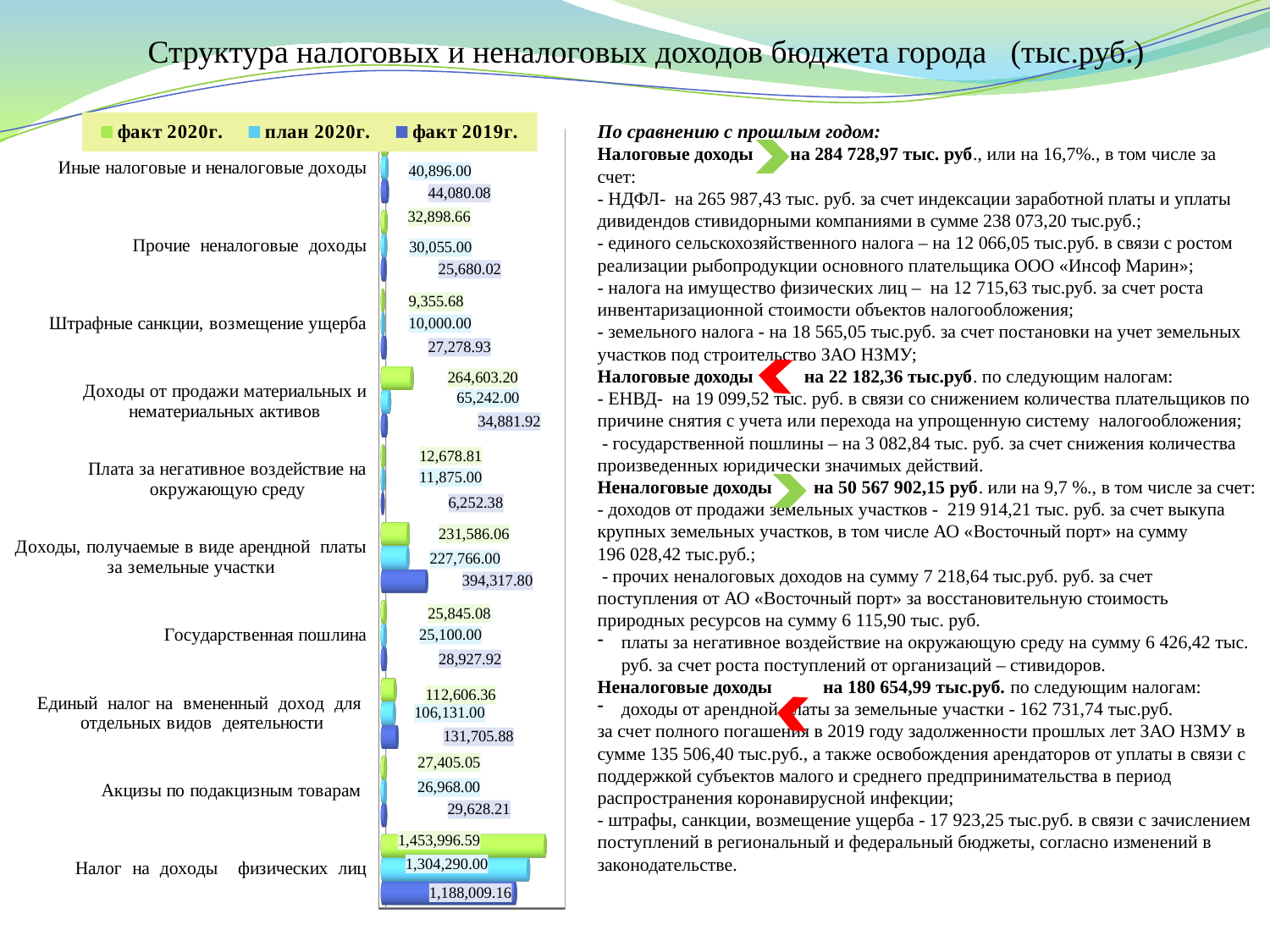
What is the факт 2020г. value for Налог на доходы физических лиц? 1,453,996.59 What colour represents the факт 2019г. series in the legend? blue Which category has the highest факт 2020г. value? Налог на доходы физических лиц How many series does the chart legend list? 3 What is the план 2020г. value for Государственная пошлина? 25,100.00 For Доходы от продажи материальных и нематериальных активов, which is larger: факт 2020г. or план 2020г.? факт 2020г. What kind of chart is shown on the slide? bar chart What is the difference between the факт 2020г. and факт 2019г. values for Налог на доходы физических лиц? 265,987.43 How many categories are plotted on the chart? 10 What is the difference between the факт 2019г. and факт 2020г. values for Штрафные санкции, возмещение ущерба? 17,923.25 What is the факт 2019г. value for Доходы, получаемые в виде арендной платы за земельные участки? 394,317.80 What is the факт 2019г. value for Единый налог на вмененный доход для отдельных видов деятельности? 131,705.88